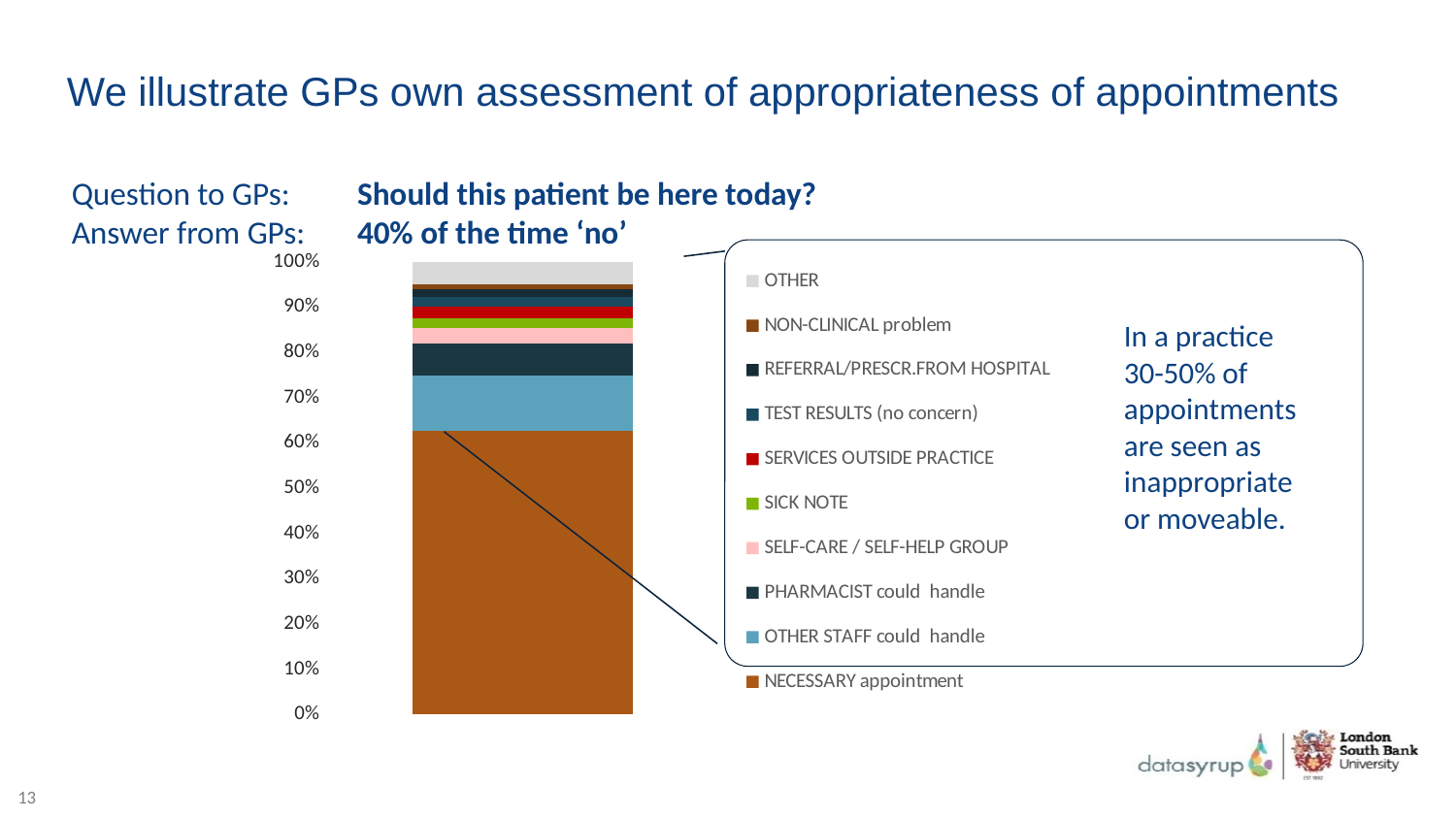
Which legend entry is listed first (at the top) in the chart's legend? OTHER What is the total height of the stacked bar on the percentage axis? 100% What kind of chart is shown on the slide? Stacked bar chart Is the share for NECESSARY appointment greater or less than 50%? greater Which category forms the bottom segment of the stacked bar? NECESSARY appointment Which legend category takes up the largest segment of the bar? NECESSARY appointment Which segment is larger: OTHER STAFF could handle or SICK NOTE? OTHER STAFF could handle Which segment is larger: NECESSARY appointment or OTHER STAFF could handle? NECESSARY appointment Is the share for OTHER STAFF could handle greater or less than 20%? less How many bars are plotted in the chart? 1 How many entries does the chart's legend list? 10